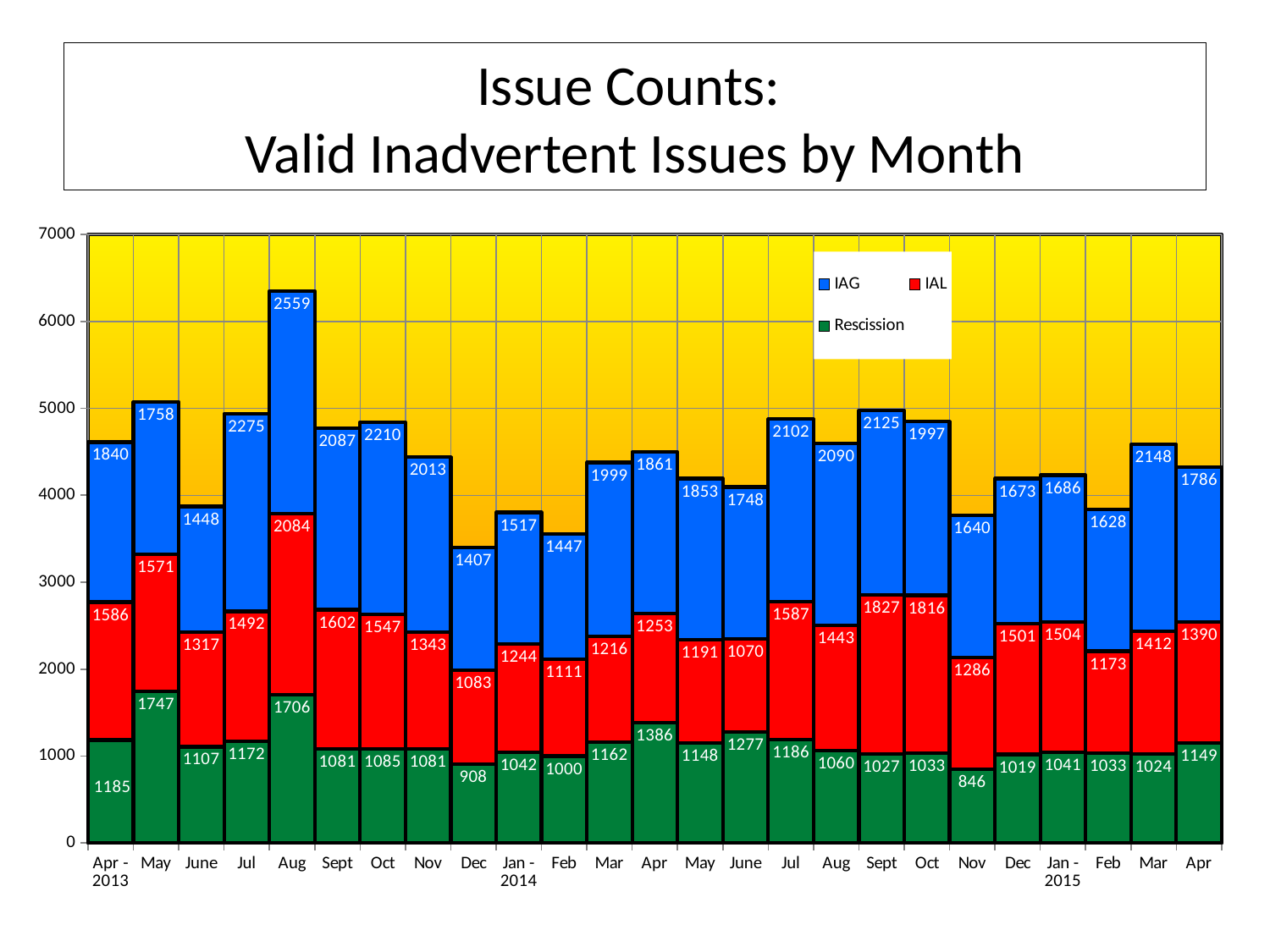
What is the IAL value for Sept 2014? 1827 How many series does the legend list? 3 What is the total of the stacked bar for Aug 2013? 6349 Which month has the highest IAG value? Aug 2013 How many months are plotted on the x axis? 25 Which is larger, the IAL value for May 2013 or the IAL value for June 2013? May 2013 Which series is shown in green? Rescission What is the IAG value for Aug 2013? 2559 What type of chart is shown on the slide? stacked bar chart What is the Rescission value for Nov 2014? 846 Which month has the lowest Rescission value? Nov 2014 What is the difference between the IAG values for Aug 2013 and Jul 2013? 284